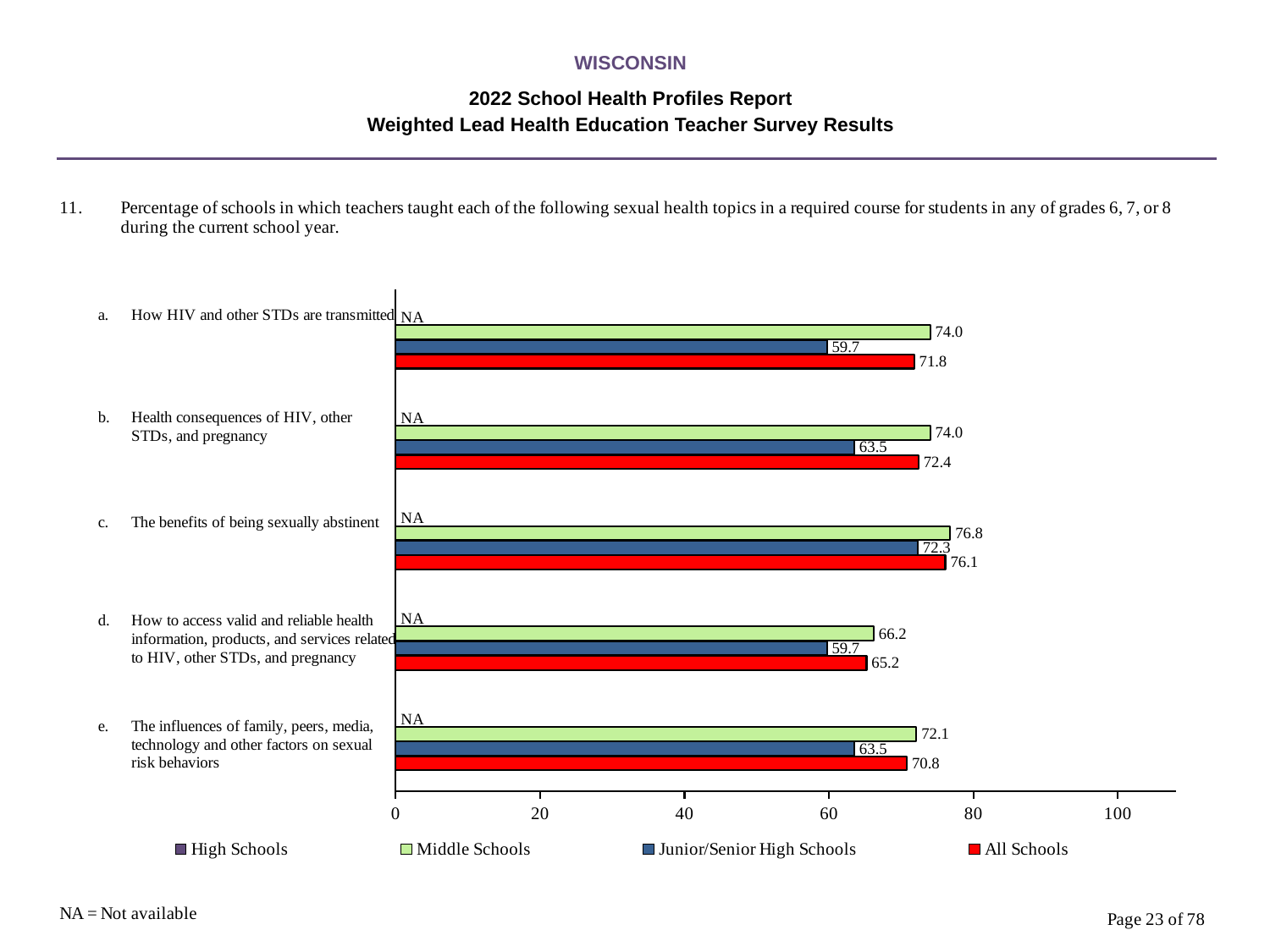
How many series does the legend list? 4 Which topic has the lowest All Schools value? d. How to access valid and reliable health information, products, and services related to HIV, other STDs, and pregnancy What does NA stand for, according to the note on the slide? Not available What is the Junior/Senior High Schools value for topic e, "The influences of family, peers, media, technology and other factors on sexual risk behaviors"? 63.5 How many sexual health topics are listed on the chart? 5 What is shown for High Schools for topic b, "Health consequences of HIV, other STDs, and pregnancy"? NA Which topic has the highest Middle Schools value? c. The benefits of being sexually abstinent What is the Middle Schools value for topic a, "How HIV and other STDs are transmitted"? 74.0 What kind of chart is shown on the slide? Bar chart What is the difference between the Middle Schools and Junior/Senior High Schools values for topic a, "How HIV and other STDs are transmitted"? 14.3 For topic d, is the Middle Schools value or the All Schools value larger? Middle Schools What is the All Schools value for topic c, "The benefits of being sexually abstinent"? 76.1